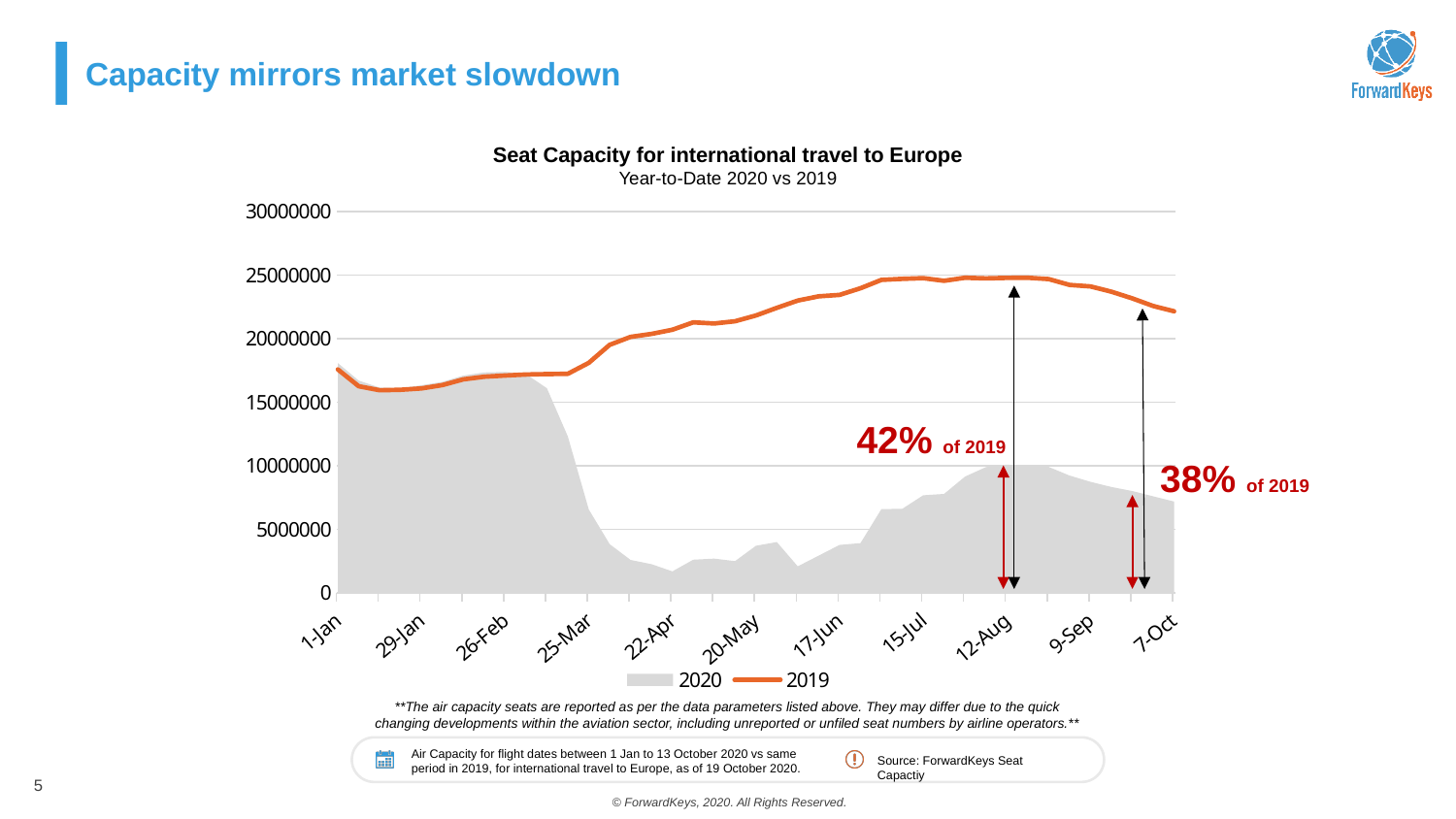
Does the 2020 series rise or fall between 26-Feb and 22-Apr? fall Which colour represents the 2019 series in the chart? Orange Is the 2020 value at 22-Apr greater or less than 5000000? less At 12-Aug, which series has the larger value, 2019 or 2020? 2019 Is the 2019 value at 15-Jul greater or less than 20000000? greater Is the 2020 value at 1-Jan greater or less than 15000000? greater How many series does the legend list? 2 According to the annotation, what percentage of 2019 capacity did 2020 reach around 7-Oct? 38% What is the title of the chart? Seat Capacity for international travel to Europe According to the annotation, what percentage of 2019 capacity did 2020 reach around 12-Aug? 42% How many date labels are shown on the x axis? 11 Does the 2019 series rise or fall between 25-Mar and 15-Jul? rise